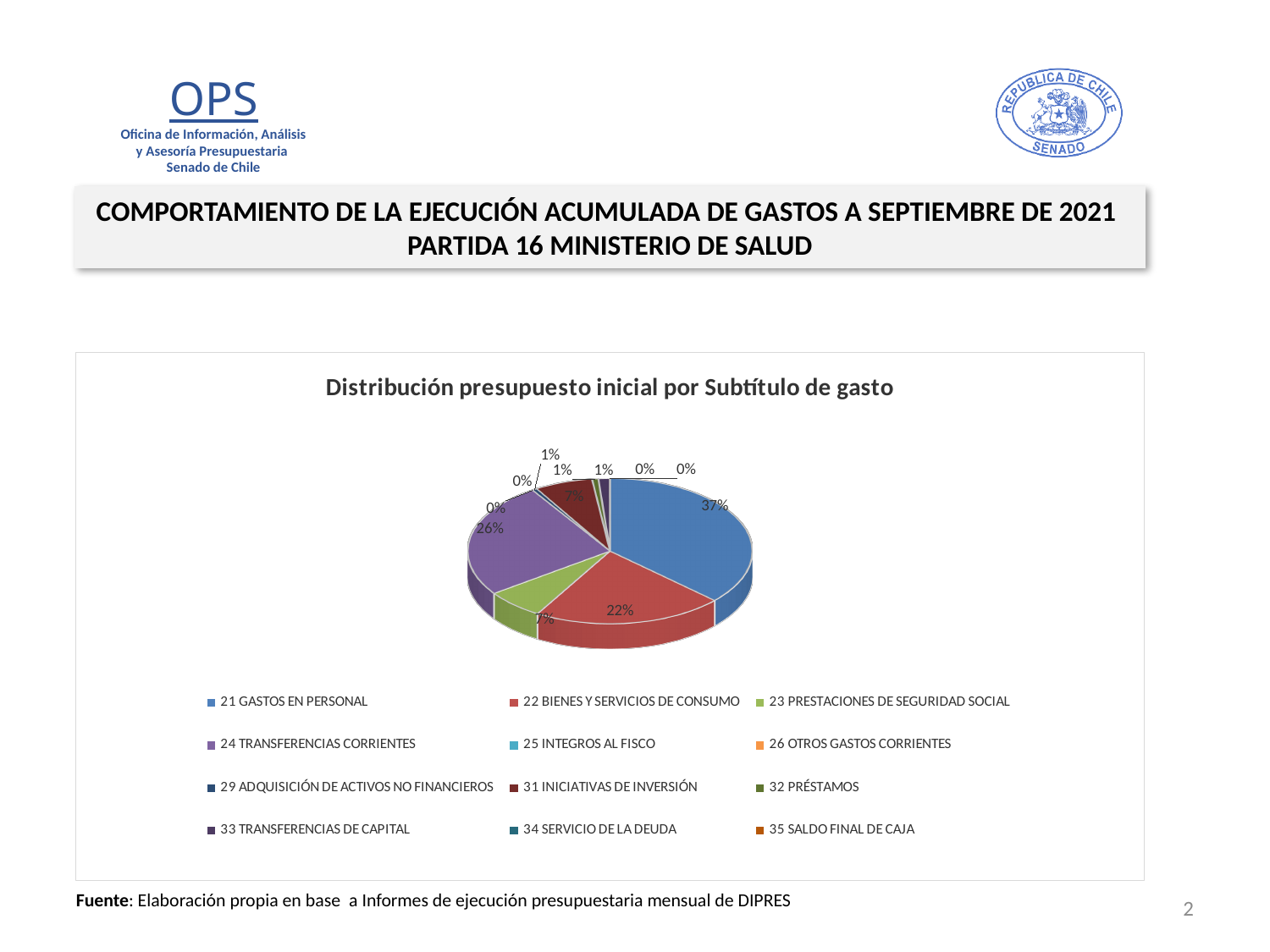
Which category has the largest share of the pie? 21 GASTOS EN PERSONAL What type of chart is shown on the slide? Pie chart What is the title of the chart? Distribución presupuesto inicial por Subtítulo de gasto Which is larger: the share for 22 BIENES Y SERVICIOS DE CONSUMO or for 23 PRESTACIONES DE SEGURIDAD SOCIAL? 22 BIENES Y SERVICIOS DE CONSUMO What share of the pie does 21 GASTOS EN PERSONAL represent? 37% What is the value shown for 23 PRESTACIONES DE SEGURIDAD SOCIAL? 7% What is the value shown for 22 BIENES Y SERVICIOS DE CONSUMO? 22% What is the value shown for 24 TRANSFERENCIAS CORRIENTES? 26% Which is larger: the share for 21 GASTOS EN PERSONAL or for 24 TRANSFERENCIAS CORRIENTES? 21 GASTOS EN PERSONAL How many categories does the chart legend list? 12 What is the difference in percentage points between 24 TRANSFERENCIAS CORRIENTES and 22 BIENES Y SERVICIOS DE CONSUMO? 4 percentage points What is the difference in percentage points between 21 GASTOS EN PERSONAL and 22 BIENES Y SERVICIOS DE CONSUMO? 15 percentage points